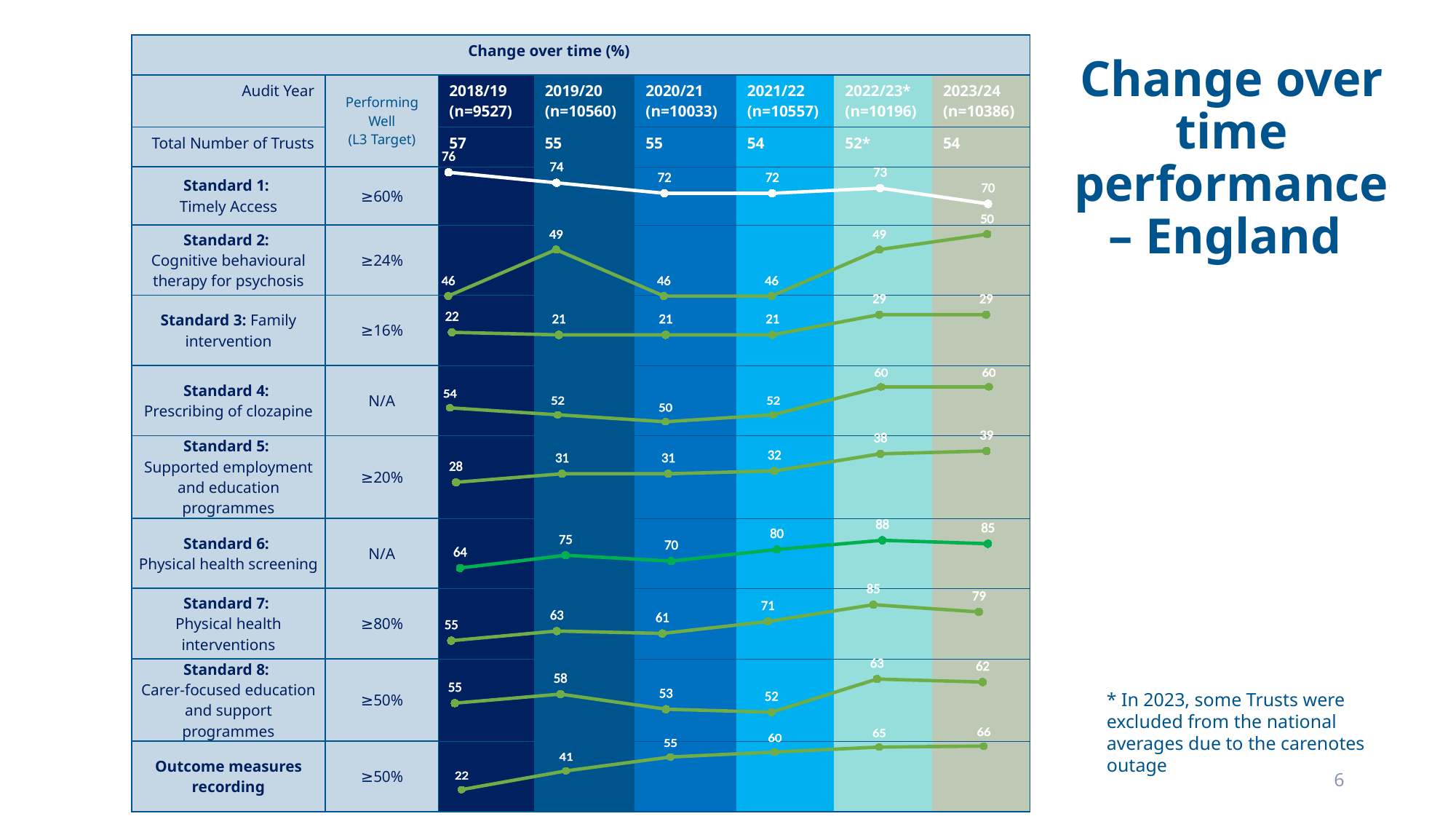
In the Standard 5: Supported employment and education programmes row, what is the difference between the 2023/24 value and the 2018/19 value? 11 How many audit years are plotted in each row of the chart? 6 In the Standard 8: Carer-focused education and support programmes row, which is larger, the value for 2019/20 or the value for 2021/22? 2019/20 In the Standard 7: Physical health interventions row, which audit year has the highest value? 2022/23 In the Standard 1: Timely Access row, what is the value for 2018/19? 76 What kind of chart is used in each row of the table? line chart In the Standard 3: Family intervention row, what is the difference between the 2022/23 value and the 2021/22 value? 8 In the Standard 1: Timely Access row, which audit year has the lowest value? 2023/24 In the Outcome measures recording row, what is the value for 2023/24? 66 In the Outcome measures recording row, do the values generally rise or fall from 2018/19 to 2023/24? rise What is the Performing Well (L3 Target) shown for Standard 7: Physical health interventions? ≥80% In the Standard 6: Physical health screening row, what is the value for 2022/23? 88